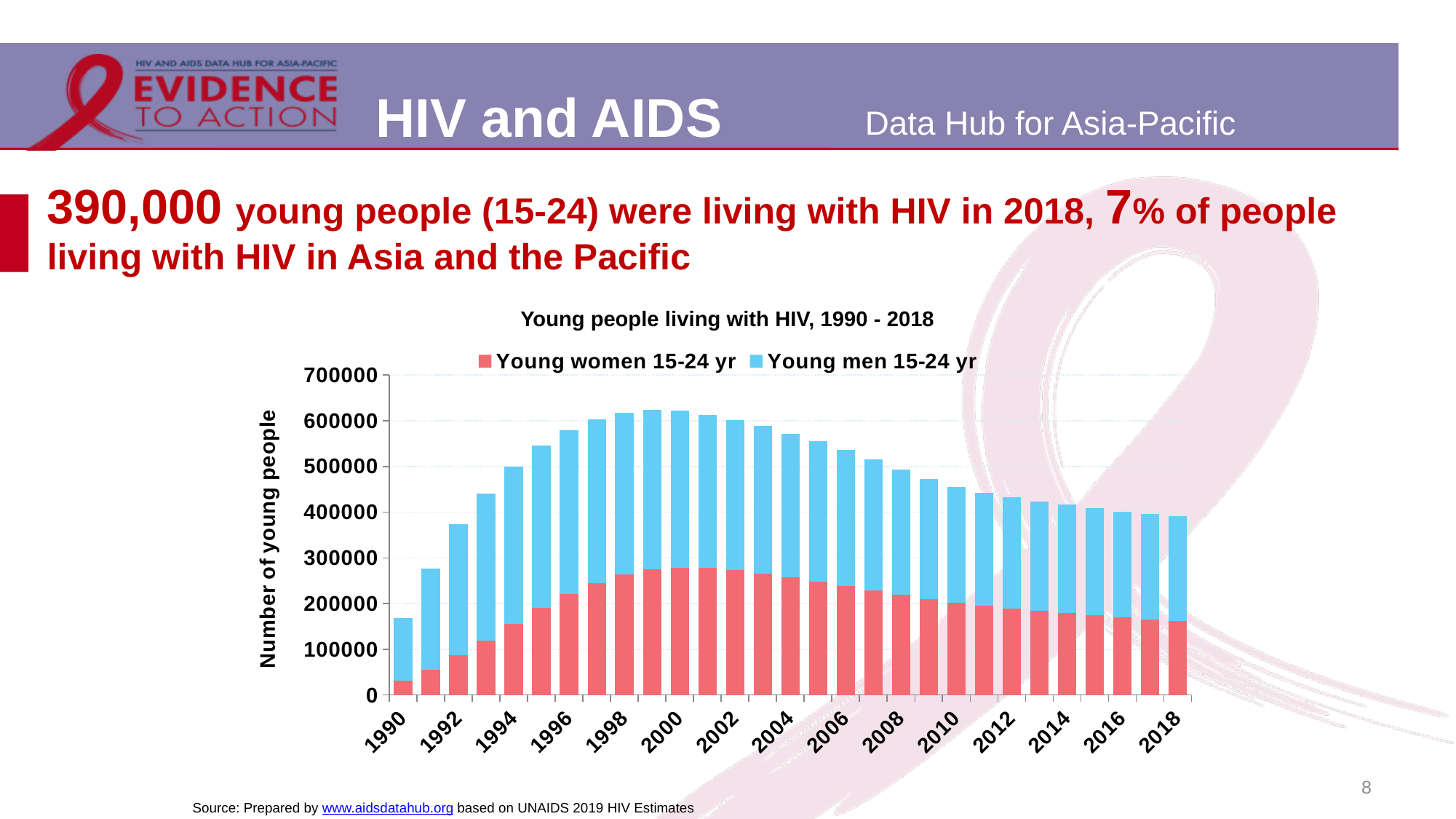
How many series does the legend of the chart list? 2 Which year has the lowest total number of young people living with HIV? 1990 Is the total value for 1990 greater or less than 200000? less In 2018, which series is larger: Young women 15-24 yr or Young men 15-24 yr? Young men 15-24 yr Is the total value for 1995 greater or less than 600000? less How many years (bars) are plotted in the chart? 29 What is the title of the chart? Young people living with HIV, 1990 - 2018 What kind of chart is shown on the slide? Stacked bar chart Is the total value for 1999 greater or less than 600000? greater Do the total values rise or fall from 2000 to 2018? fall What are the two series named in the chart legend? Young women 15-24 yr and Young men 15-24 yr